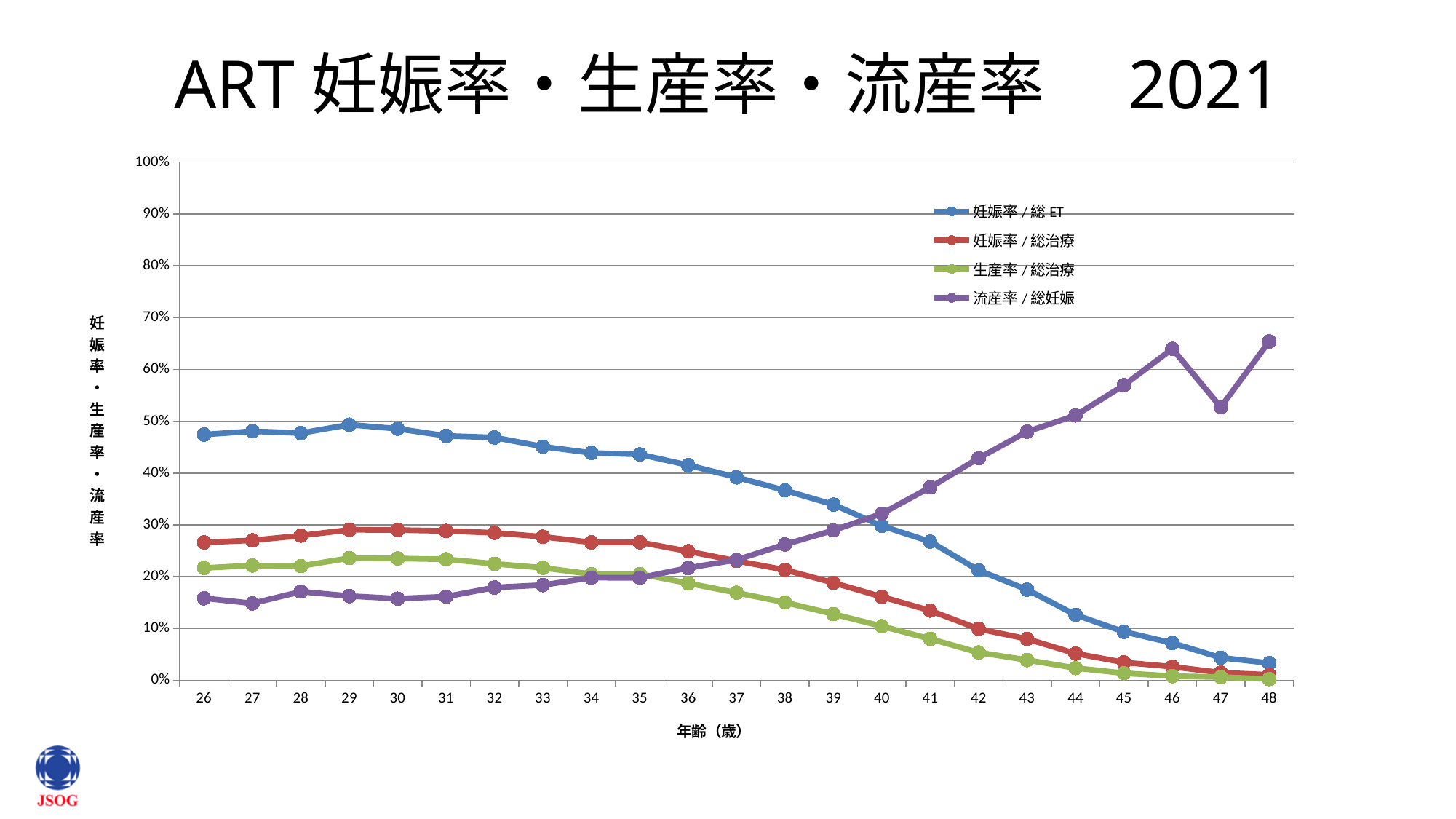
At age 42, which series has the higher value, 妊娠率 / 総 ET or 流産率 / 総妊娠? 流産率 / 総妊娠 Does the 妊娠率 / 総 ET series rise or fall as age increases along the x axis? fall Is the value for 生産率 / 総治療 at age 40 greater or less than 20%? less What is the label of the x axis? 年齢（歳） Is the value for 流産率 / 総妊娠 at age 46 greater or less than 60%? greater Is the value for 妊娠率 / 総治療 at age 48 greater or less than 10%? less Does the 流産率 / 総妊娠 series generally rise or fall as age increases along the x axis? rise What kind of chart is shown on the slide? line chart How many age categories are plotted along the x axis? 23 How many series does the legend list? 4 At which age is the 妊娠率 / 総 ET series lowest? 48